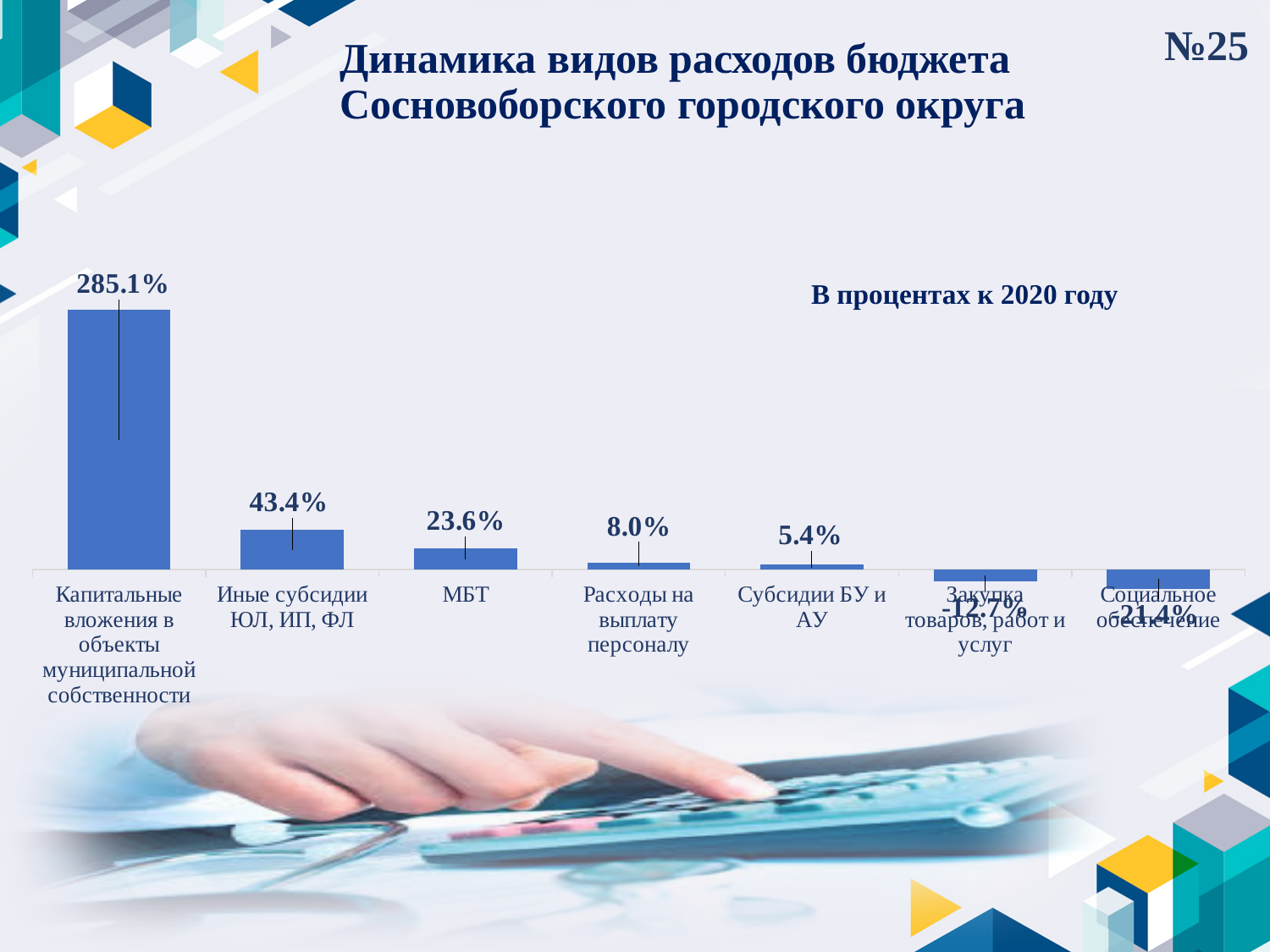
What is the title of the chart? Динамика видов расходов бюджета Сосновоборского городского округа Do the values rise or fall moving from left to right along the x axis? Fall What type of chart is shown on the slide? Bar chart What is the value for МБТ? 23.6% What is the value for Закупка товаров, работ и услуг? -12.7% Which category has the lowest value? Социальное обеспечение What is the value for Социальное обеспечение? -21.4% What is the value for Иные субсидии ЮЛ, ИП, ФЛ? 43.4% Which is larger: the value for Иные субсидии ЮЛ, ИП, ФЛ or the value for МБТ? Иные субсидии ЮЛ, ИП, ФЛ What is the difference between the values for Расходы на выплату персоналу and Субсидии БУ и АУ? 2.6% Which category has the highest value? Капитальные вложения в объекты муниципальной собственности How many categories are plotted in the chart? 7